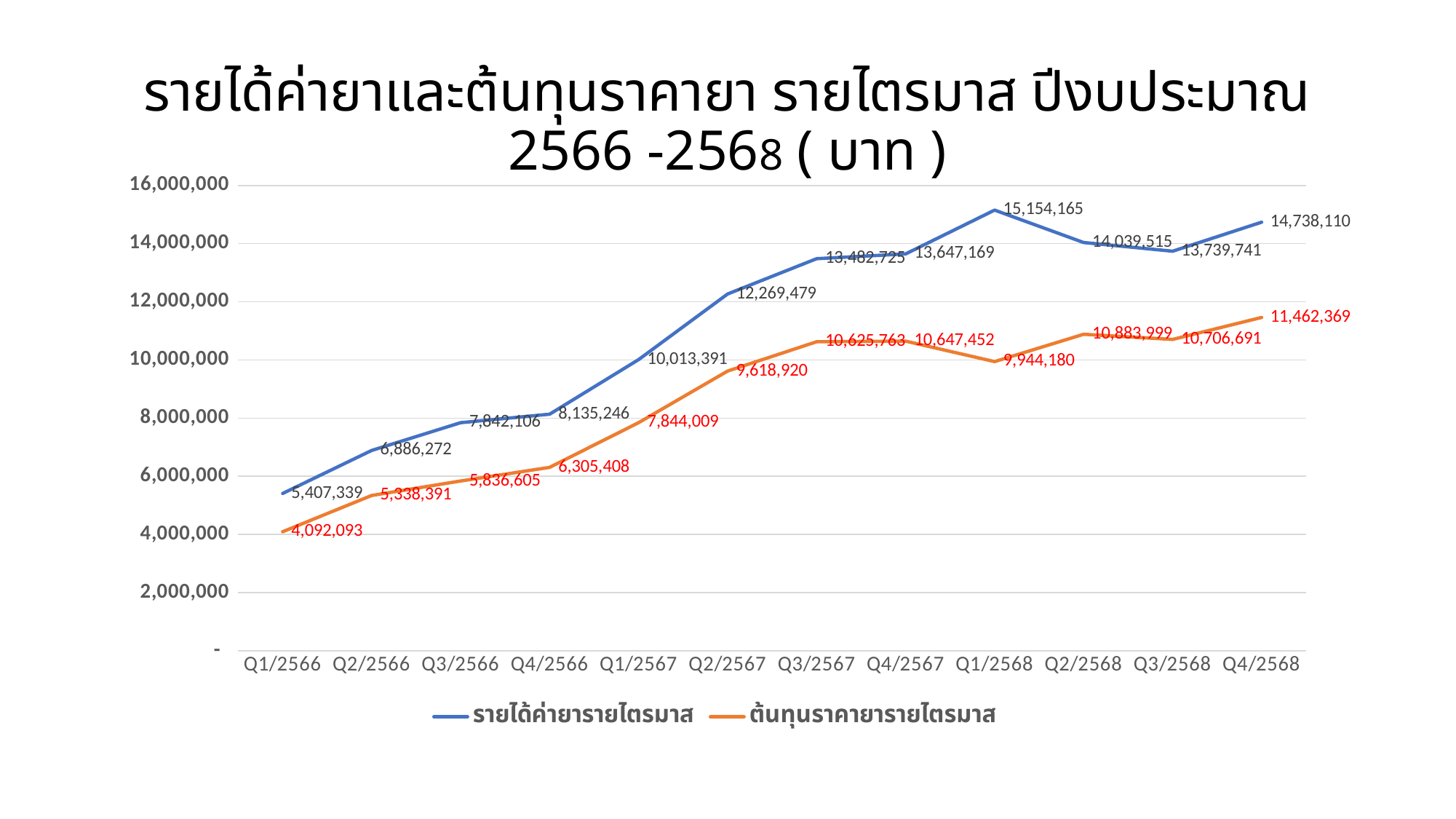
Is the value of ต้นทุนราคายารายไตรมาส for Q3/2567 greater or less than 10,000,000? greater How many series does the legend list? 2 What is the value of ต้นทุนราคายารายไตรมาส for Q2/2567? 9,618,920 What is the value of รายได้ค่ายารายไตรมาส for Q1/2568? 15,154,165 What kind of chart is shown on the slide? line chart In which quarter is รายได้ค่ายารายไตรมาส highest? Q1/2568 How many quarters are shown on the x axis? 12 What is the value of รายได้ค่ายารายไตรมาส for Q4/2566? 8,135,246 What is the difference between รายได้ค่ายารายไตรมาส and ต้นทุนราคายารายไตรมาส in Q4/2568? 3,275,741 In which quarter is ต้นทุนราคายารายไตรมาส highest? Q4/2568 In which quarter is ต้นทุนราคายารายไตรมาส lowest? Q1/2566 Which is larger in Q1/2568: รายได้ค่ายารายไตรมาส or ต้นทุนราคายารายไตรมาส? รายได้ค่ายารายไตรมาส